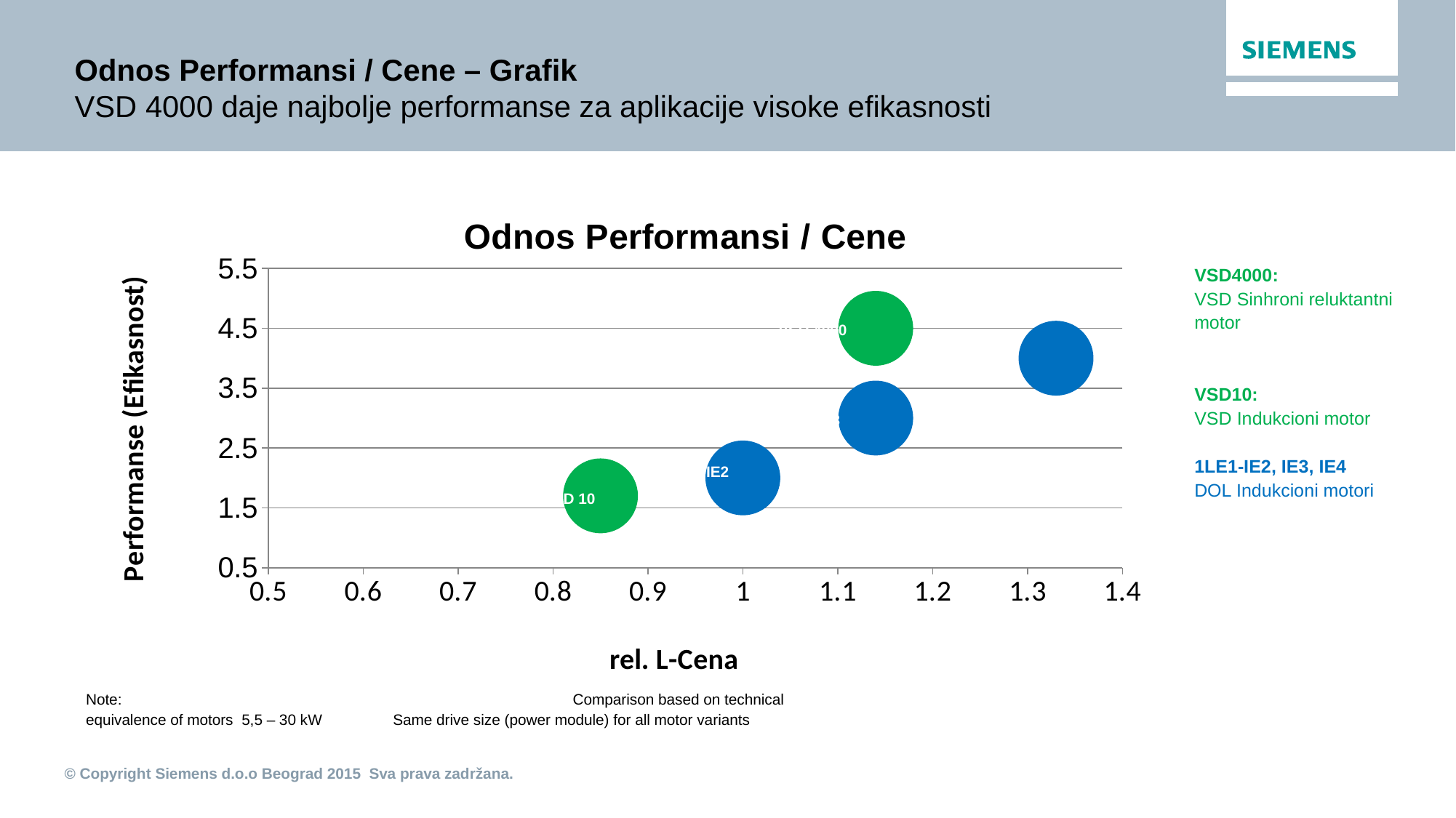
What is the label of the x axis of the chart? rel. L-Cena Is the rel. L-Cena value for the VSD 10 bubble greater or less than 0.9? less How many bubbles are plotted on the chart? 5 Which bubble has the higher Performanse (Efikasnost) value, VSD 10 or IE2? IE2 What is the title of the chart? Odnos Performansi / Cene Is the rel. L-Cena value for the VSD 4000 bubble greater or less than 1.1? greater Which labelled bubble is plotted highest on the Performanse (Efikasnost) axis? VSD 4000 Which labelled bubble is plotted lowest on the Performanse (Efikasnost) axis? VSD 10 What kind of chart is shown on the slide? Bubble chart Is the rel. L-Cena value for the rightmost bubble greater or less than 1.3? greater Which bubble has the higher rel. L-Cena value, VSD 4000 or IE2? VSD 4000